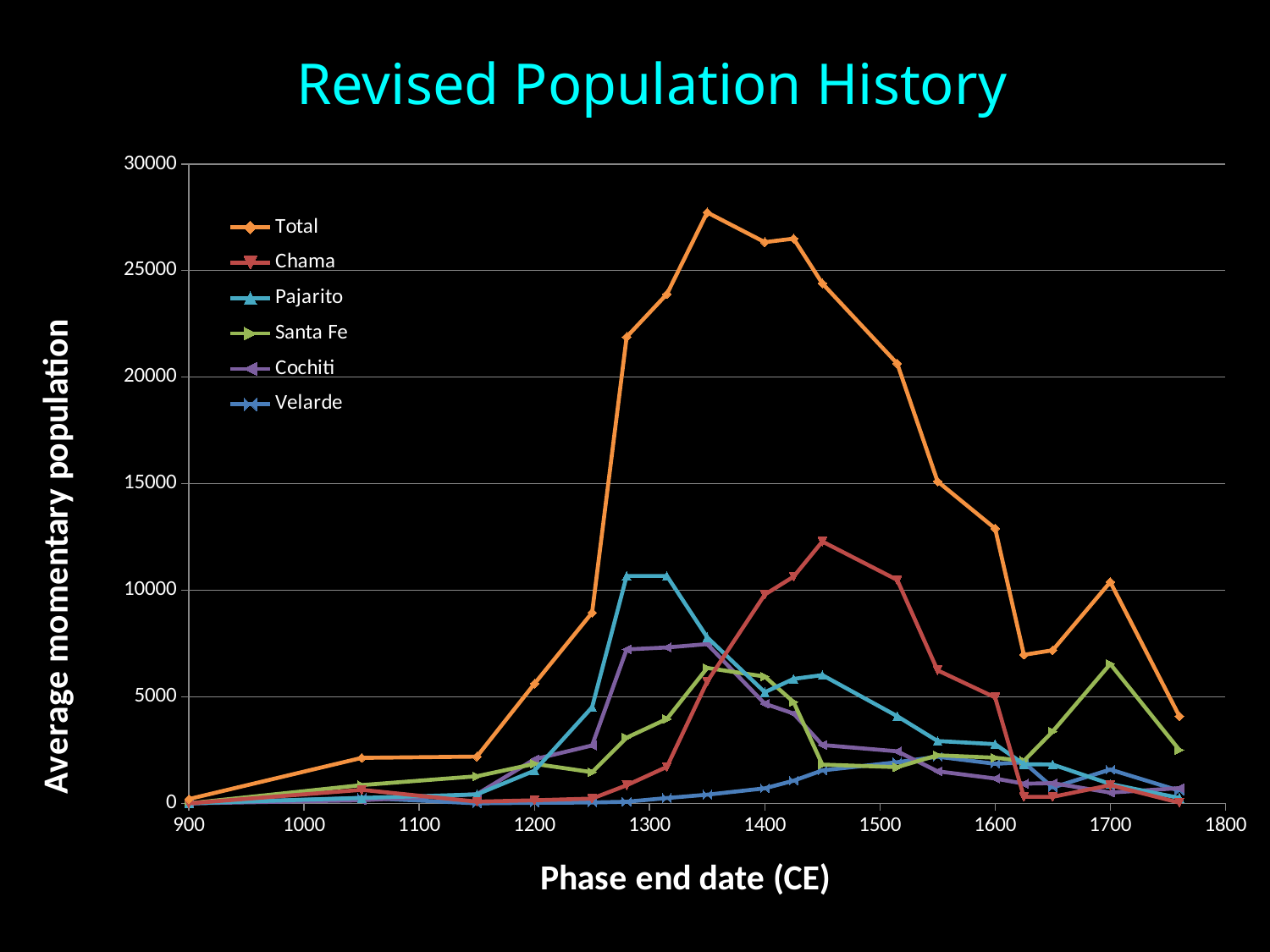
What is the label of the y axis? Average momentary population Does the Total series rise or fall between 1350 and 1625? fall Is the value of the Velarde series at 1700 greater or less than 5000? less At 1450, which series has the larger value, Chama or Pajarito? Chama What is the title of the chart? Revised Population History Is the value of the Santa Fe series at 1700 greater or less than 5000? greater What kind of chart is shown on the slide? line chart Is the value of the Total series at 1625 greater or less than 10000? less Which series reaches the highest value on the chart? Total How many series does the legend list? 6